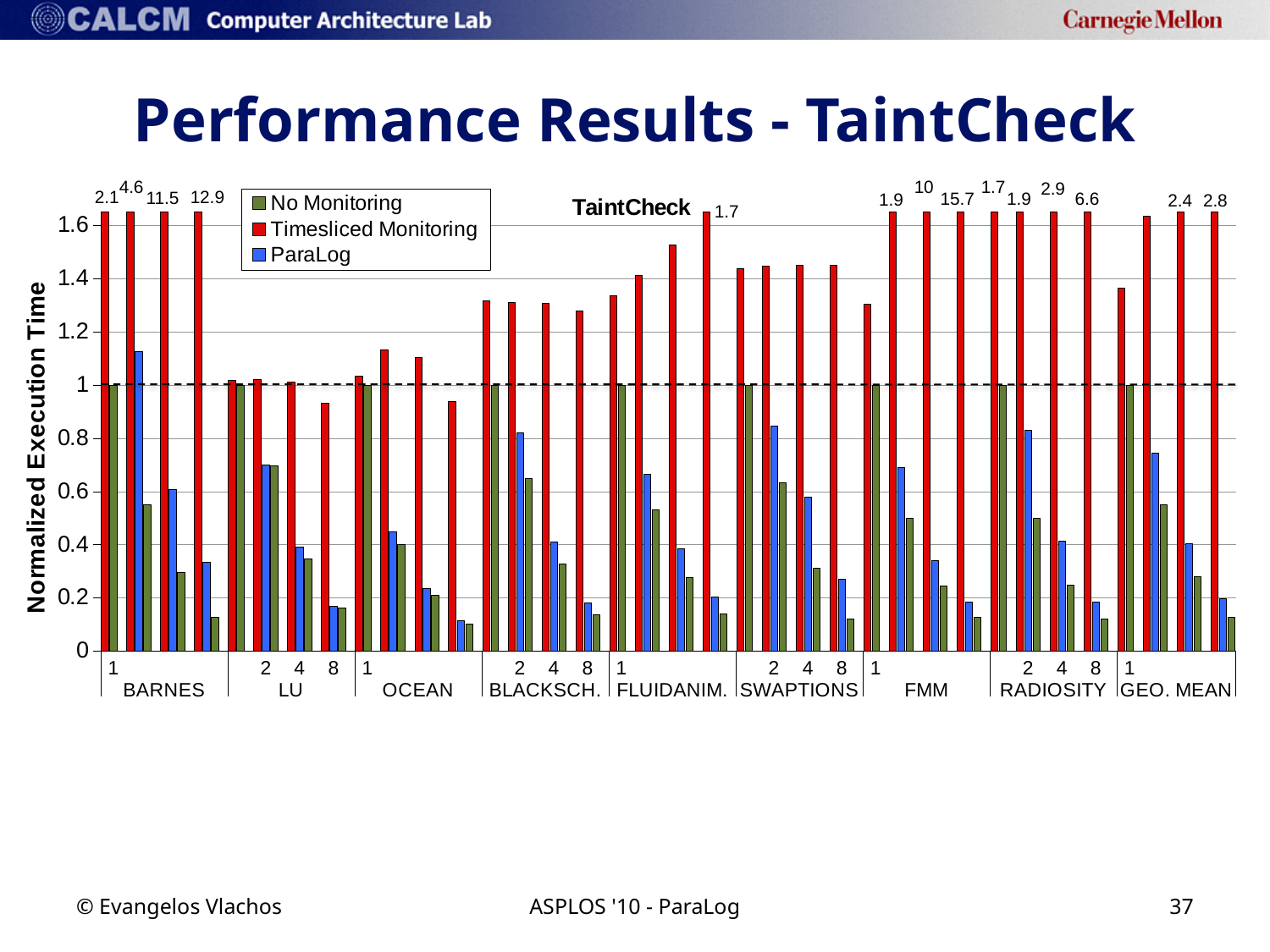
What is the difference between the Timesliced Monitoring values for BARNES at 8 threads and at 1 thread? 10.8 What is the label of the y axis? Normalized Execution Time Is the Timesliced Monitoring value for LU at 8 threads greater or less than 1? less What is the Timesliced Monitoring value for RADIOSITY at 8 threads? 6.6 Among the Timesliced Monitoring values printed above the chart, which benchmark and thread count has the highest value? FMM at 8 threads (15.7) What is the Timesliced Monitoring value for GEO. MEAN at 8 threads? 2.8 What is the Timesliced Monitoring value for FMM at 8 threads? 15.7 Is the ParaLog value for BARNES at 2 threads greater or less than 1? greater Which is larger: the Timesliced Monitoring value for BARNES at 8 threads or for FMM at 8 threads? FMM at 8 threads What is the Timesliced Monitoring value for BARNES at 8 threads? 12.9 What kind of chart is shown on the slide? bar chart How many series does the legend list? 3